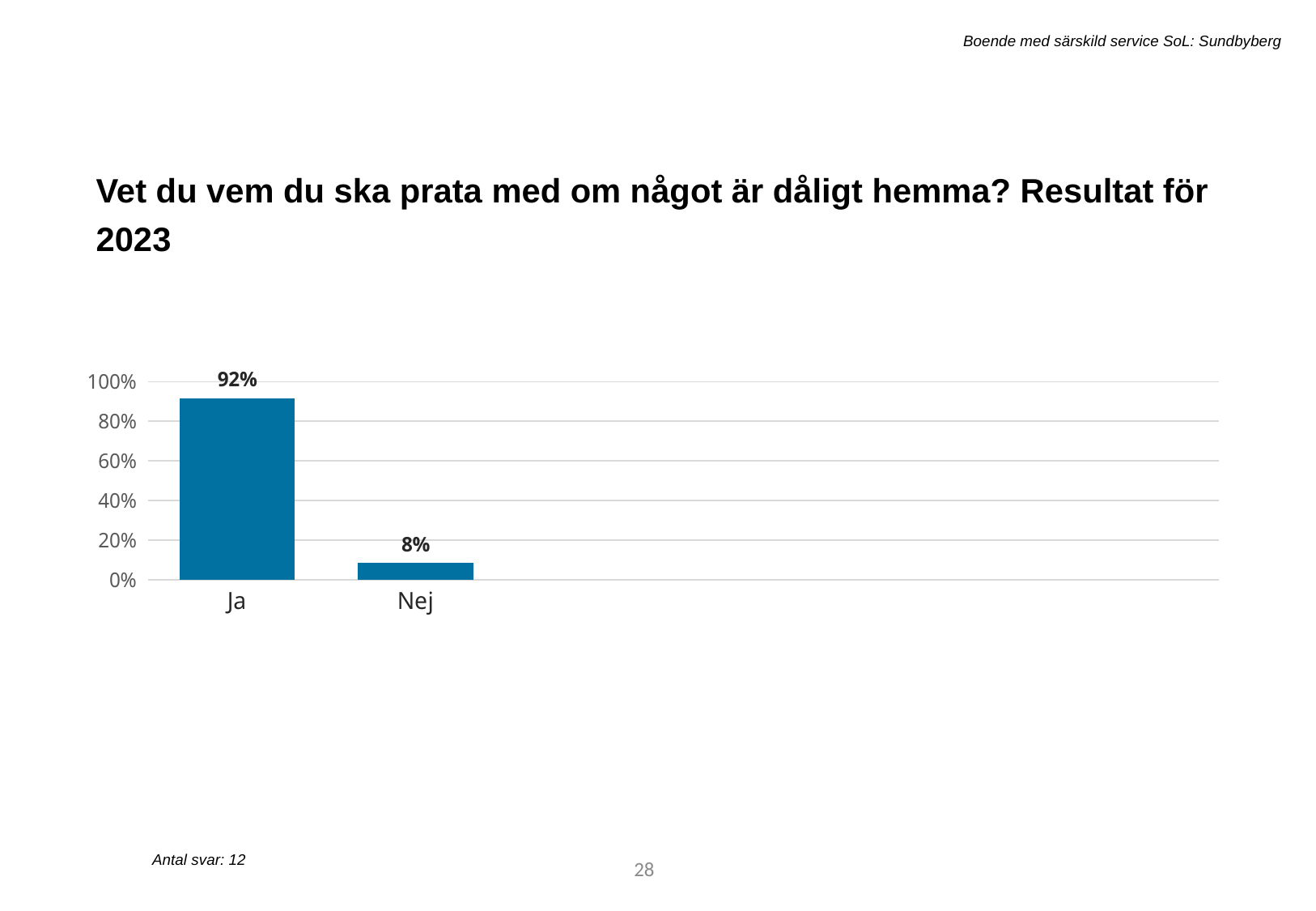
What is the total of the values for Ja and Nej? 100% What is the value for Nej? 8% What kind of chart is shown on the slide? bar chart What is the highest value shown on the y axis? 100% Which category has the lowest value? Nej Which category has the highest value? Ja How many categories are shown on the x axis? 2 Is the value for Nej greater or less than 20%? less What is the value for Ja? 92% Which is larger, the value for Ja or the value for Nej? Ja What is the difference between the values for Ja and Nej? 84% Is the value for Ja greater or less than 80%? greater